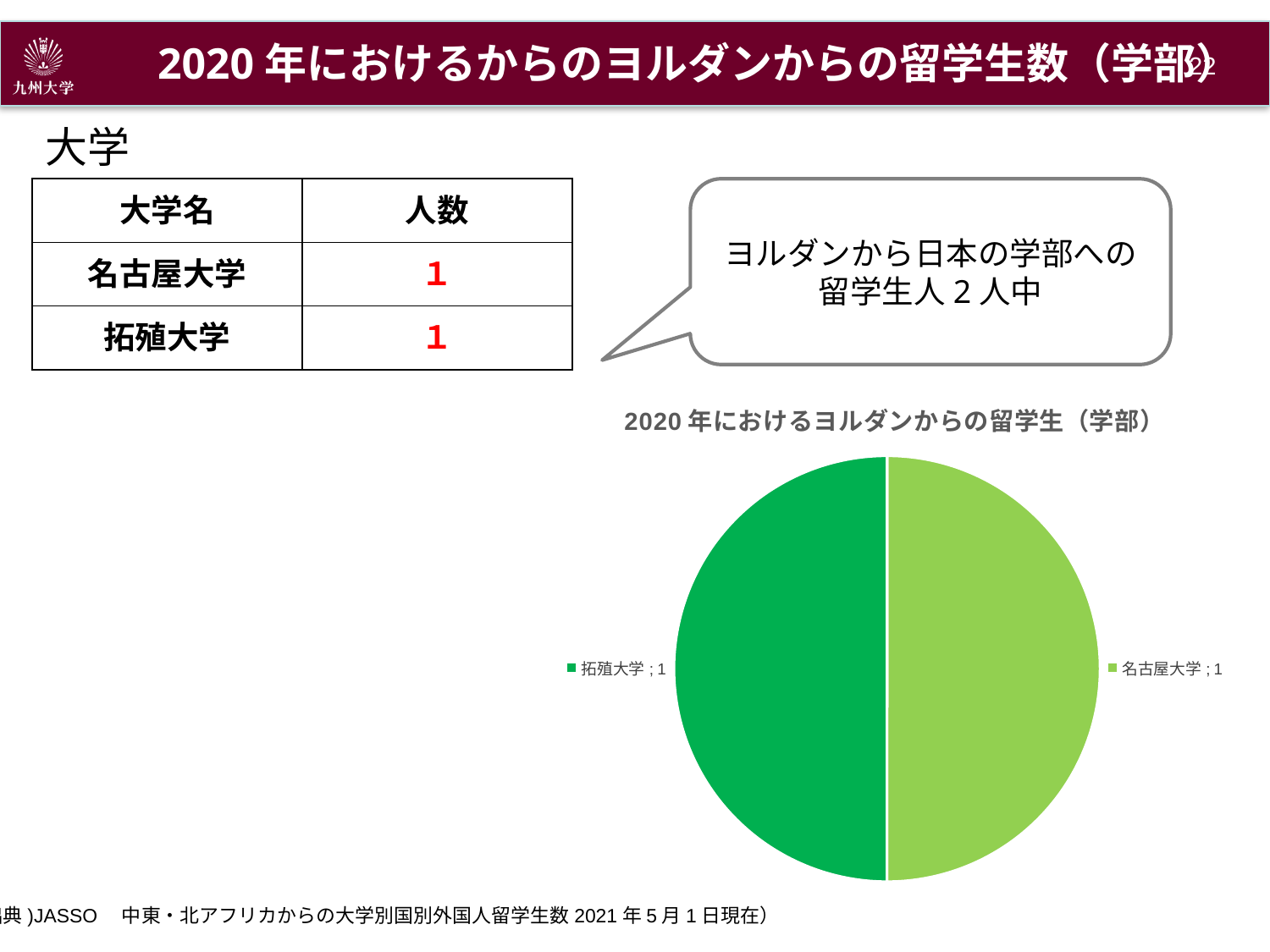
What share of the pie does 拓殖大学 represent? 50% What is the total of the values shown in the pie chart? 2 What is the value shown for 名古屋大学 in the pie chart? 1 What is the difference between the values for 拓殖大学 and 名古屋大学 in the pie chart? 0 What share of the pie does 名古屋大学 represent? 50% What kind of chart is shown on the slide? pie chart What is the title of the pie chart? 2020年におけるヨルダンからの留学生（学部） Which slice of the pie chart is shown in the lighter green colour? 名古屋大学 How many slices does the pie chart have? 2 What is the value shown for 拓殖大学 in the pie chart? 1